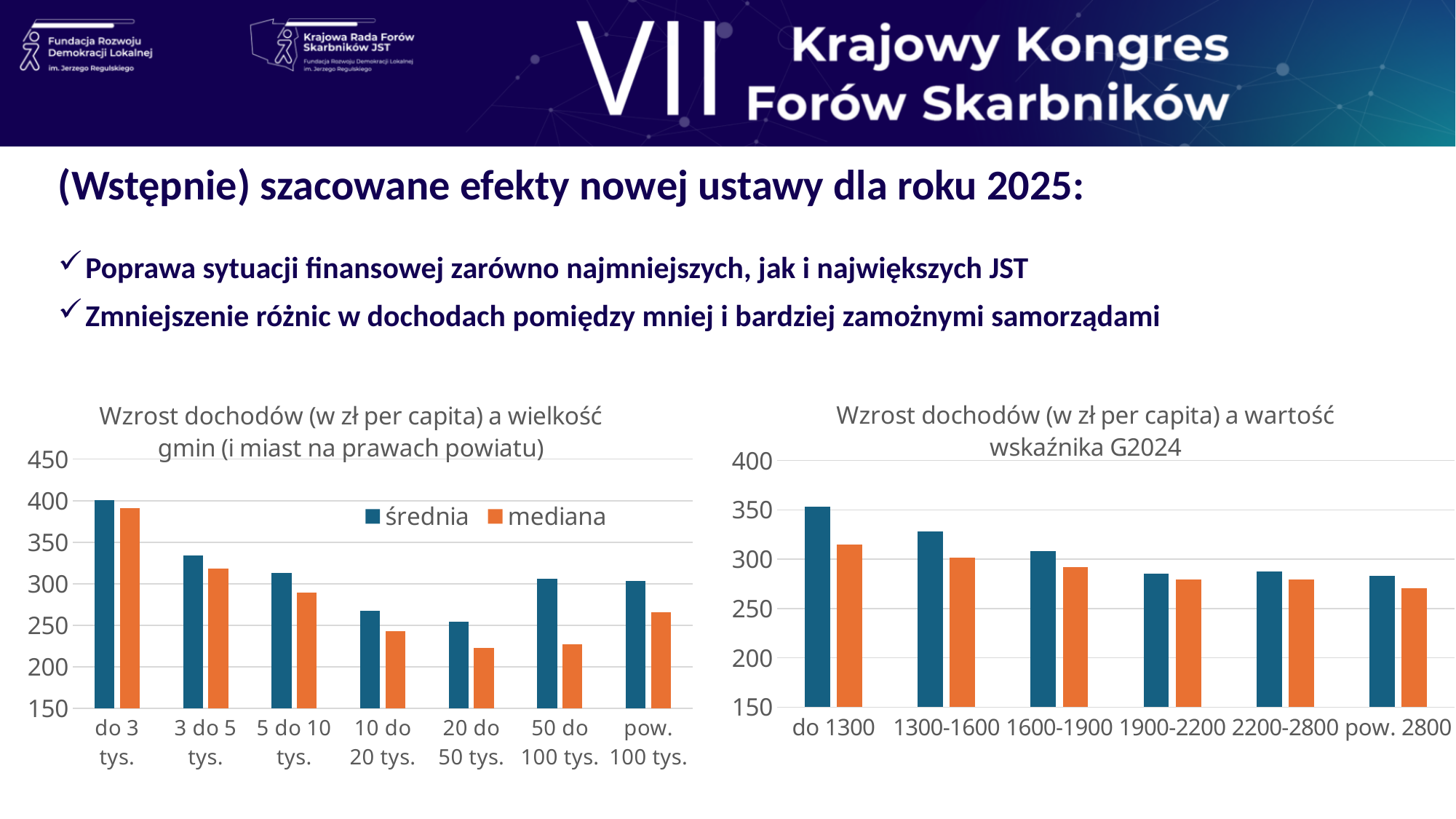
In the left chart (wielkość gmin), how many size categories are shown on the x axis? 7 In the right chart (wskaźnik G2024), is the blue bar for 1300-1600 greater or less than 300? greater In the right chart (wskaźnik G2024), is the orange bar for pow. 2800 greater or less than 300? less In the left chart (wielkość gmin), which category has the lowest mediana value? 20 do 50 tys. In the left chart (wielkość gmin), is the średnia value for 10 do 20 tys. greater or less than 300? less In the right chart (wskaźnik G2024), how many categories are shown on the x axis? 6 In the right chart (wskaźnik G2024), which category has the highest blue bar? do 1300 In the left chart (wielkość gmin), which category has the highest średnia value? do 3 tys. What kind of chart is the left chart titled "Wzrost dochodów (w zł per capita) a wielkość gmin (i miast na prawach powiatu)"? bar chart In the left chart (wielkość gmin), for the category 5 do 10 tys., which is larger: średnia or mediana? średnia In the left chart (wielkość gmin), how many series does the legend list? 2